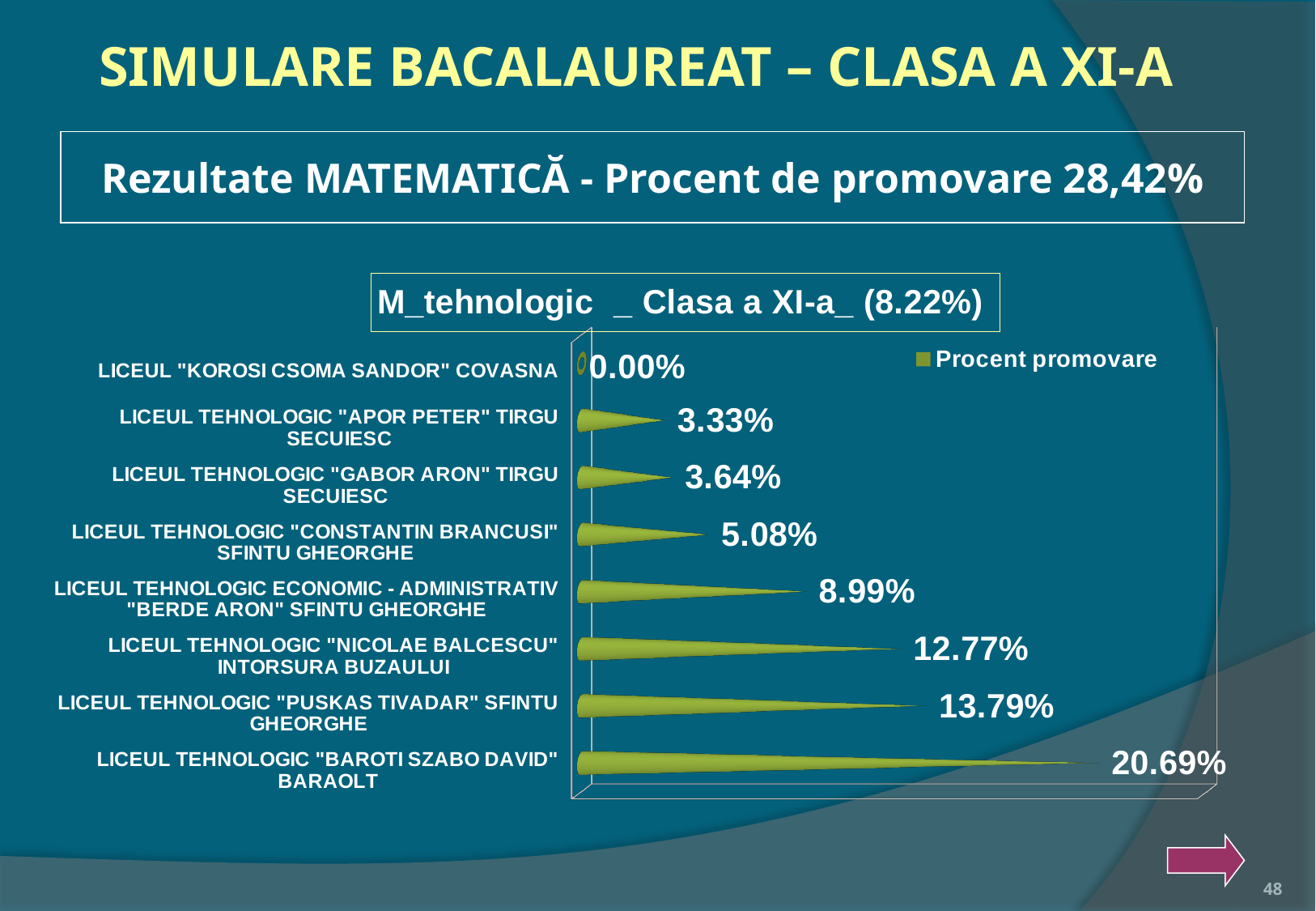
Which is larger, the value for LICEUL TEHNOLOGIC "GABOR ARON" TIRGU SECUIESC or LICEUL TEHNOLOGIC "APOR PETER" TIRGU SECUIESC? LICEUL TEHNOLOGIC "GABOR ARON" TIRGU SECUIESC What is the value for LICEUL TEHNOLOGIC ECONOMIC - ADMINISTRATIV "BERDE ARON" SFINTU GHEORGHE? 8.99% Which school has the highest value? LICEUL TEHNOLOGIC "BAROTI SZABO DAVID" BARAOLT How many series does the legend list? 1 What kind of chart is shown? Bar chart What is the value for LICEUL "KOROSI CSOMA SANDOR" COVASNA? 0.00% What is the value for LICEUL TEHNOLOGIC "BAROTI SZABO DAVID" BARAOLT? 20.69% What is the title of the chart? M_tehnologic _ Clasa a XI-a_ (8.22%) What is the value for LICEUL TEHNOLOGIC "NICOLAE BALCESCU" INTORSURA BUZAULUI? 12.77% How many schools are shown in the chart? 8 Which school has the lowest value? LICEUL "KOROSI CSOMA SANDOR" COVASNA What is the difference between the values for LICEUL TEHNOLOGIC "PUSKAS TIVADAR" SFINTU GHEORGHE and LICEUL TEHNOLOGIC "NICOLAE BALCESCU" INTORSURA BUZAULUI? 1.02%